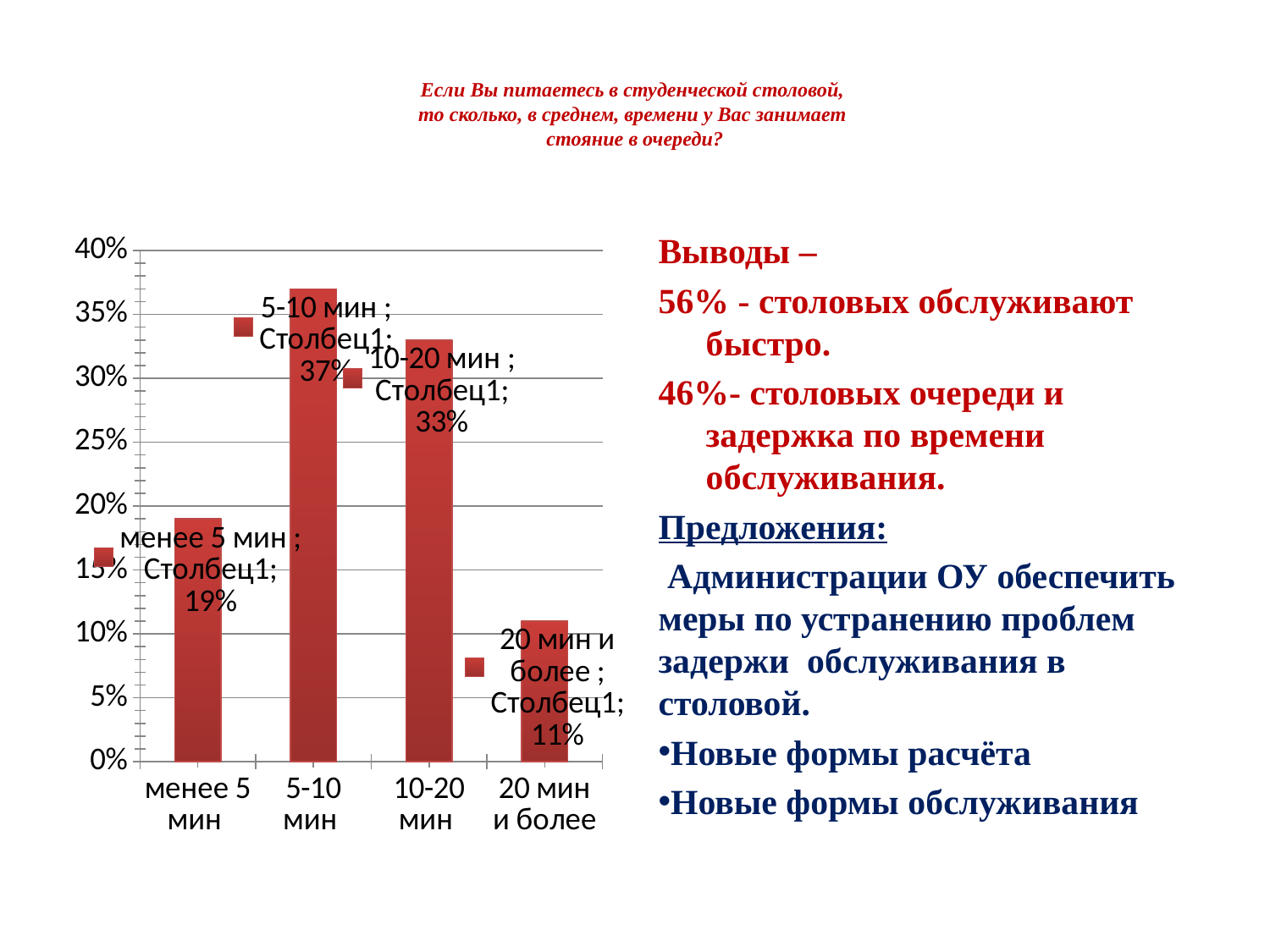
How many categories are shown on the x axis of the chart? 4 What is the name of the data series shown in the chart's data labels? Столбец1 Which is larger, the value for "менее 5 мин" or the value for "10-20 мин"? 10-20 мин What is the value for the category "20 мин и более"? 11% What is the difference between the values for "5-10 мин" and "10-20 мин"? 4% What is the value for the category "5-10 мин"? 37% Which category has the lowest value? 20 мин и более Which category has the highest value? 5-10 мин What is the value for the category "менее 5 мин"? 19% What is the difference between the values for "менее 5 мин" and "20 мин и более"? 8% What is the value for the category "10-20 мин"? 33% What kind of chart is shown on the slide? bar chart